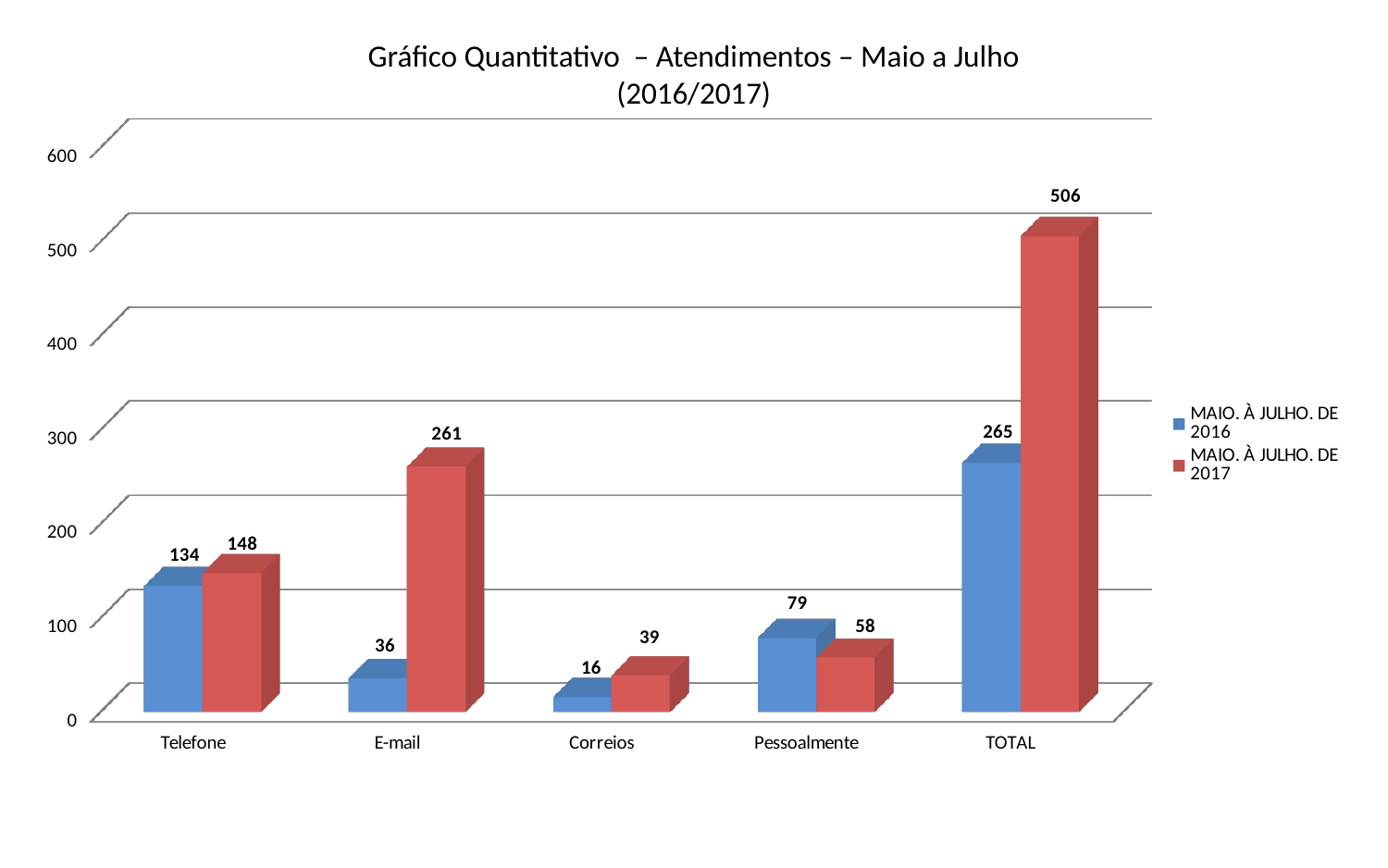
What is the value for Pessoalmente in the MAIO. À JULHO. DE 2016 series? 79 Which category has the lowest value in the MAIO. À JULHO. DE 2016 series? Correios What kind of chart is shown on the slide? Bar chart What is the value for E-mail in the MAIO. À JULHO. DE 2017 series? 261 Excluding TOTAL, which category has the highest value in the MAIO. À JULHO. DE 2017 series? E-mail What is the difference between the 2017 and 2016 TOTAL values? 241 How many series does the legend list? 2 For Pessoalmente, which series has the larger value, 2016 or 2017? MAIO. À JULHO. DE 2016 What is the difference between the 2017 and 2016 values for E-mail? 225 What is the value for Telefone in the MAIO. À JULHO. DE 2016 series? 134 What is the value for Correios in the MAIO. À JULHO. DE 2017 series? 39 How many categories are shown on the x axis? 5